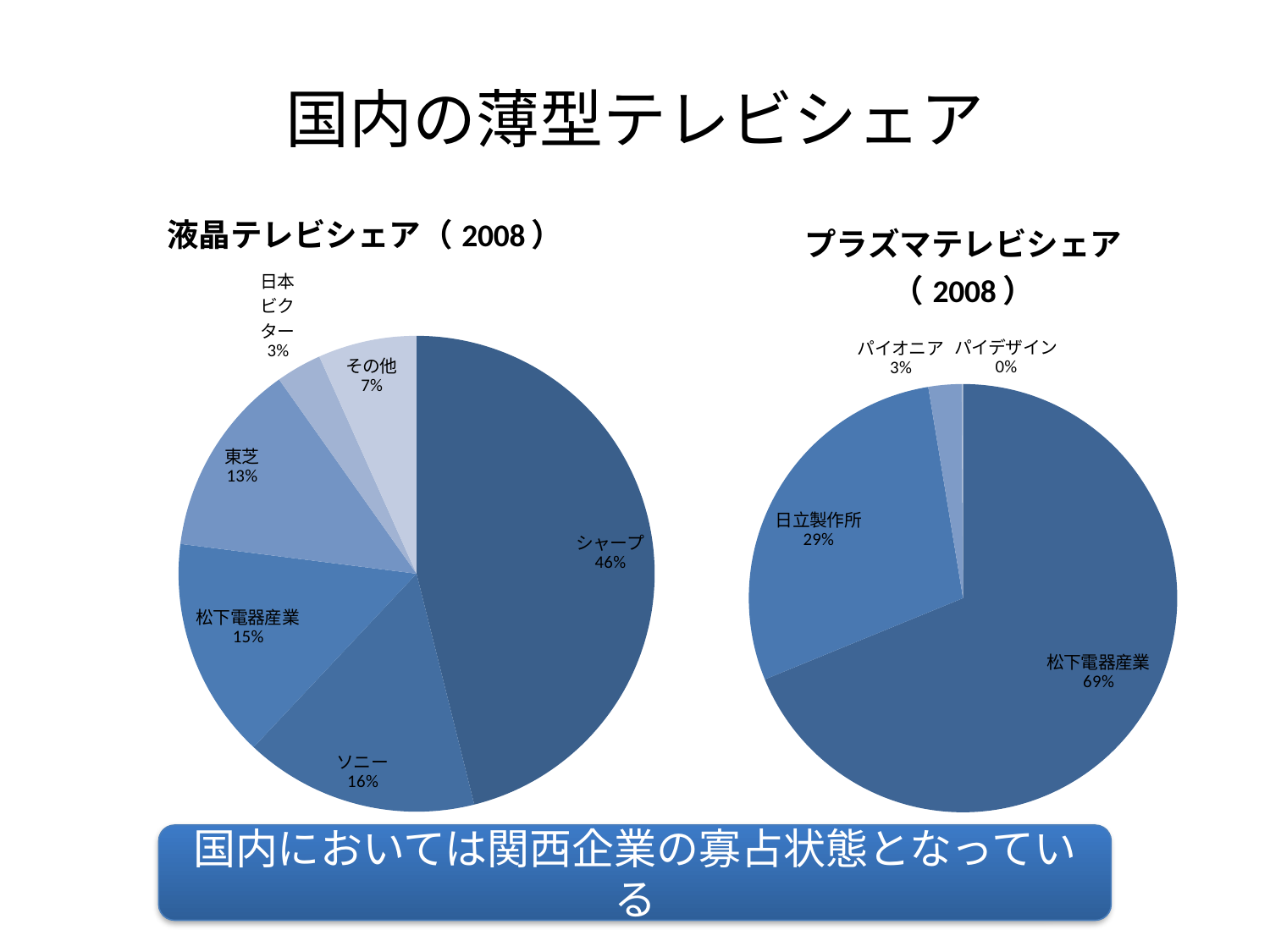
In the 液晶テレビシェア（2008） chart, how many slices does the pie have? 6 In the 液晶テレビシェア（2008） chart, which category has the smallest share? 日本ビクター In the 液晶テレビシェア（2008） chart, what share does 東芝 have? 13% What type of chart is used for the two charts on the slide? Pie chart In the プラズマテレビシェア（2008） chart, what share does 松下電器産業 have? 69% In the プラズマテレビシェア（2008） chart, which company has the largest share? 松下電器産業 In the 液晶テレビシェア（2008） chart, what share does シャープ have? 46% In the 液晶テレビシェア（2008） chart, what is the difference between the shares of シャープ and ソニー? 30% In the 液晶テレビシェア（2008） chart, which company has the largest share? シャープ In the プラズマテレビシェア（2008） chart, what is the difference between the shares of 松下電器産業 and 日立製作所? 40% In the プラズマテレビシェア（2008） chart, what share does 日立製作所 have? 29% In the プラズマテレビシェア（2008） chart, which is larger, the share of パイオニア or パイデザイン? パイオニア